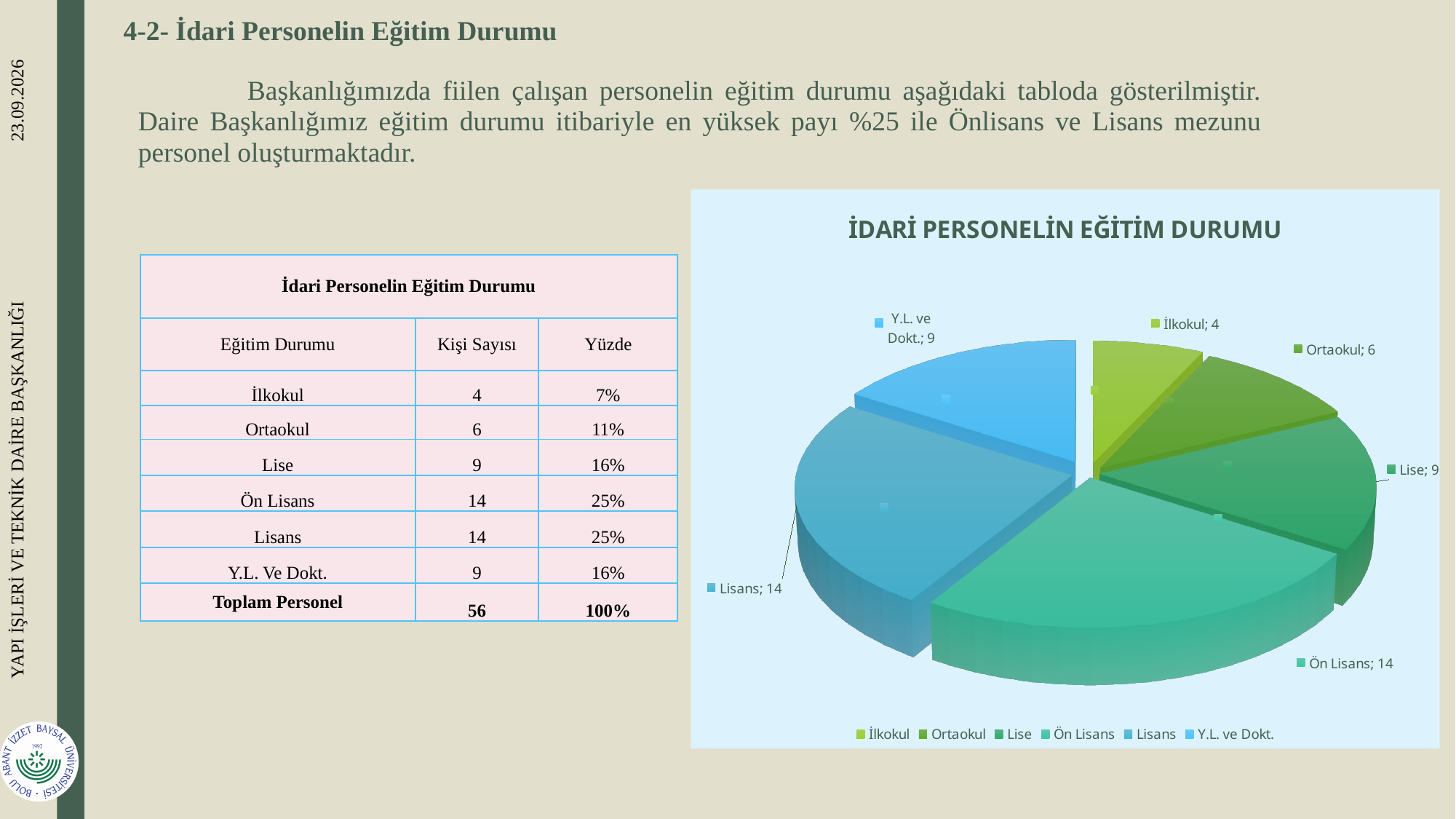
What type of chart is shown on the slide? Pie chart What is the difference between the values for Lise and Ortaokul in the pie chart? 3 Which category has the smallest slice in the pie chart? İlkokul What share of the pie does İlkokul represent? 7% What is the value for Ortaokul in the pie chart? 6 What is the value for Ön Lisans in the pie chart? 14 What is the title of the chart? İDARİ PERSONELİN EĞİTİM DURUMU Which is larger in the pie chart, Lise or Ortaokul? Lise How many entries does the chart legend list? 6 How many slices does the pie chart have? 6 What is the difference between the values for Lisans and İlkokul in the pie chart? 10 What is the value for Y.L. ve Dokt. in the pie chart? 9